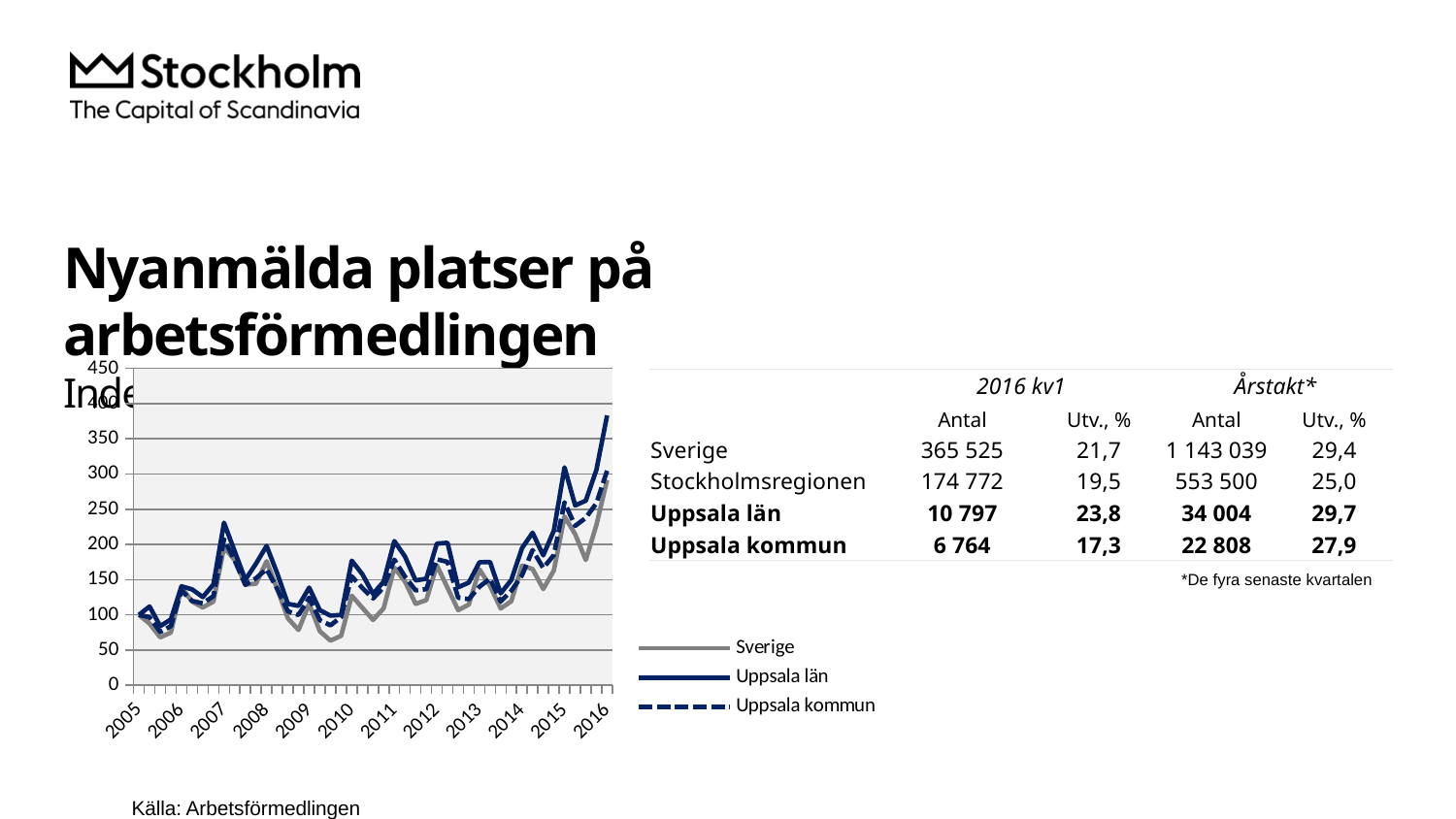
Which series has the lowest value around 2009–2010 in the chart? Sverige Which series is higher at the end of 2016, Uppsala län or Sverige? Uppsala län Is the final 2016 value for Sverige greater or less than 250? greater Do the values in the chart rise or fall from 2014 to 2016? rise Which series is drawn with a dashed line in the chart? Uppsala kommun Is the final 2016 value for Uppsala län greater or less than 300? greater How many series does the chart legend list? 3 What is the highest value shown on the chart's y axis? 450 What kind of chart is shown on the slide? line chart Is the 2007 peak value for Uppsala län greater or less than 200? greater Which series has the highest value at the end of the chart in 2016? Uppsala län